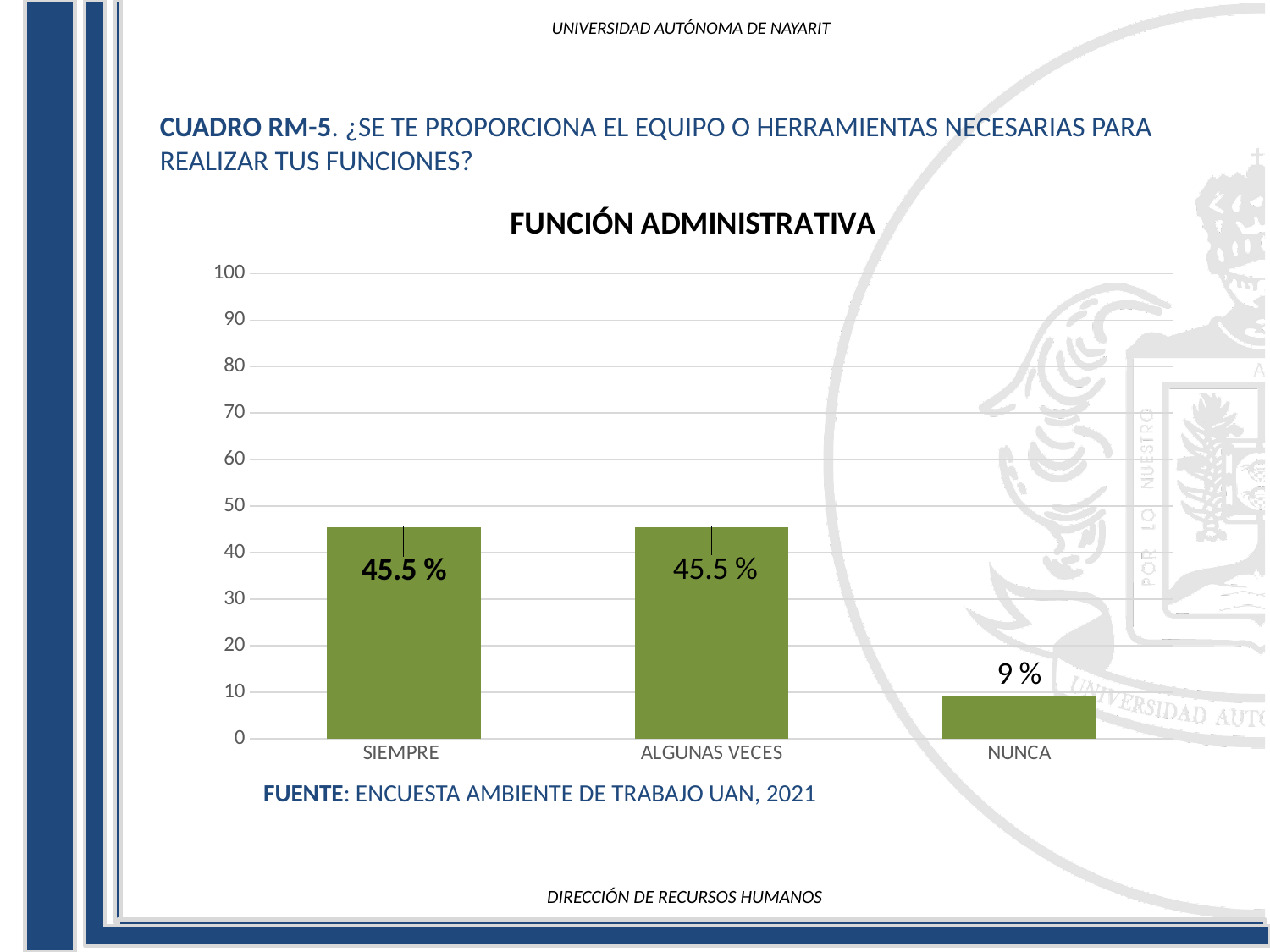
Is the value for SIEMPRE greater or less than 40? greater What kind of chart is shown on the slide? bar chart What is the highest value shown on the y axis? 100 What is the title of the chart? FUNCIÓN ADMINISTRATIVA What is the value for NUNCA? 9 % Which is larger, the value for SIEMPRE or the value for NUNCA? SIEMPRE Which category has the lowest value? NUNCA What is the value for ALGUNAS VECES? 45.5 % Is the value for NUNCA greater or less than 20? less How many categories are shown on the x axis? 3 What is the value for SIEMPRE? 45.5 % What is the difference between the value for ALGUNAS VECES and the value for NUNCA? 36.5 %